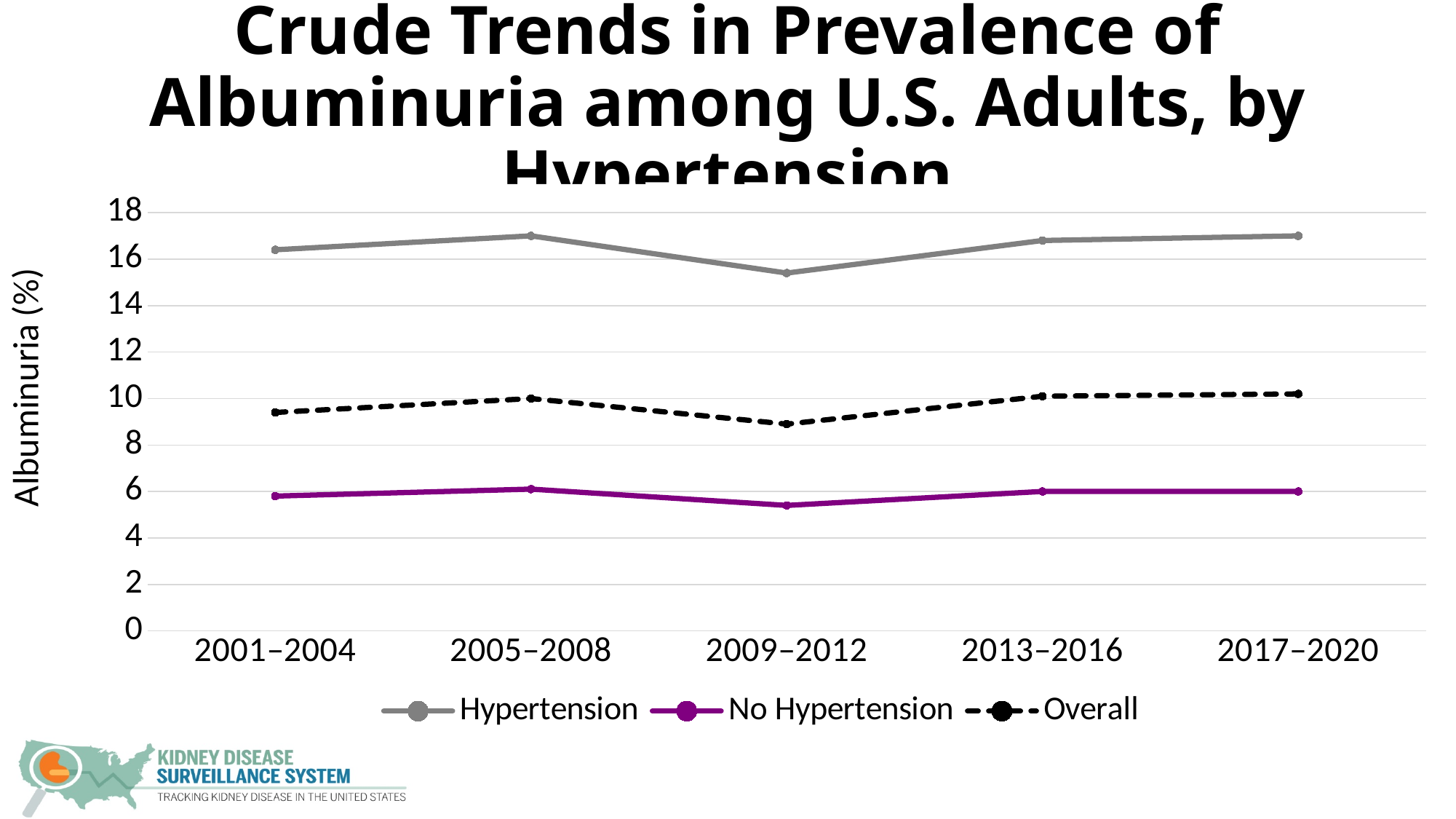
Which is larger in 2017–2020, the Hypertension value or the Overall value? Hypertension Does the Overall series rise or fall from 2005–2008 to 2009–2012? fall In which period is the Hypertension series at its lowest? 2009–2012 In which period is the Overall series at its lowest? 2009–2012 Is the value for No Hypertension in 2005–2008 greater or less than 8? less Is the value for Overall in 2009–2012 greater or less than 10? less How many series does the legend list? 3 Is the value for Hypertension in 2009–2012 greater or less than 16? less What kind of chart is shown on the slide? line chart Which series is drawn with a dashed line? Overall What is the label of the y axis? Albuminuria (%) How many time periods are shown on the x axis? 5